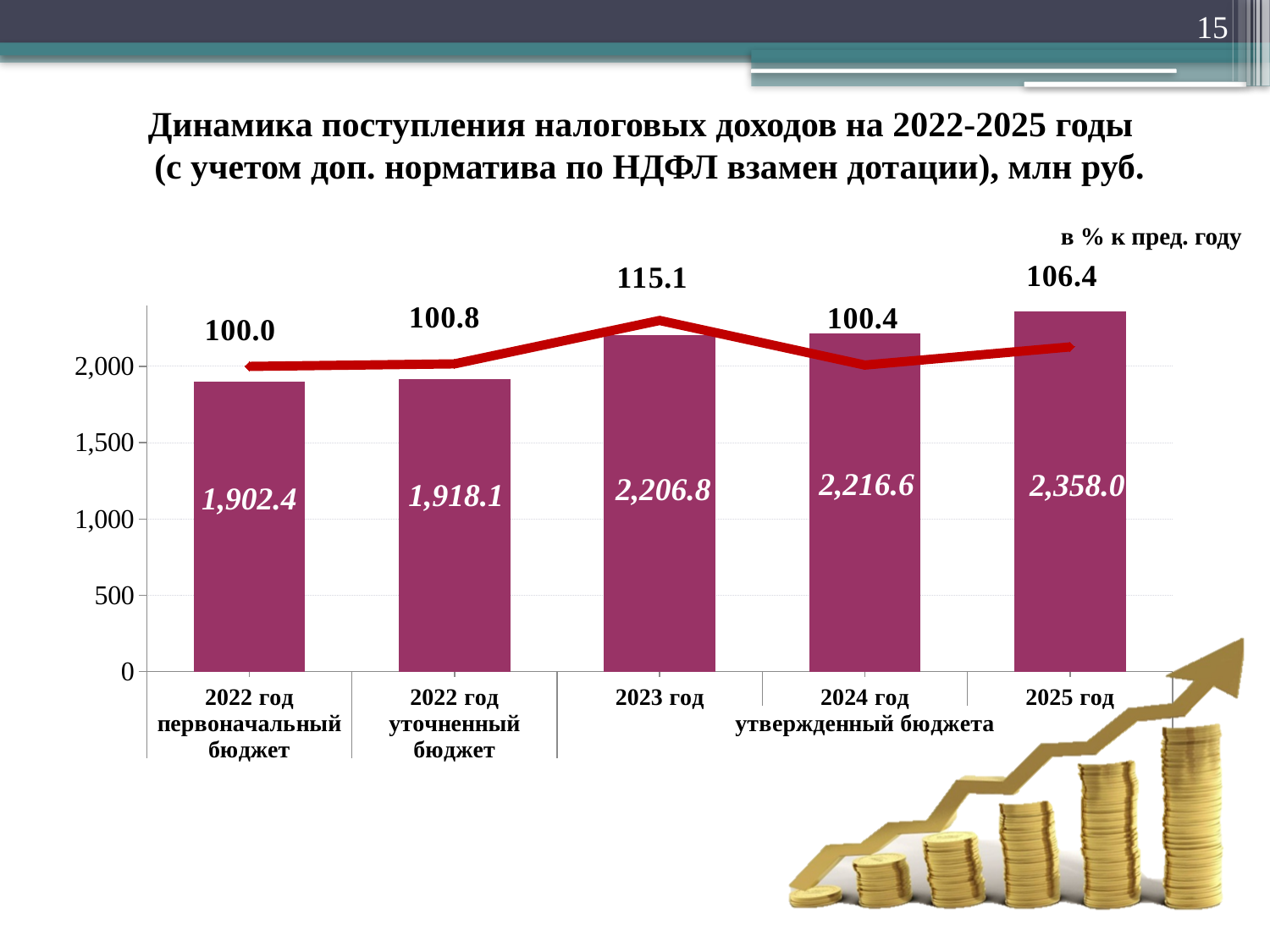
What is the value shown on the bar for 2022 год первоначальный бюджет? 1,902.4 How many bars are plotted in the chart? 5 Which category has the highest bar value? 2025 год Which is larger: the bar value for 2023 год or for 2024 год? 2024 год What is the difference between the bar values for 2022 год уточненный бюджет and 2022 год первоначальный бюджет? 15.7 Do the bar values rise or fall from left to right across the categories? rise Which category has the lowest bar value? 2022 год первоначальный бюджет What is the tax revenue value (млн руб.) shown for 2023 год? 2,206.8 What is the difference between the bar values for 2025 год and 2024 год? 141.4 Which year has the highest value on the red line (в % к пред. году)? 2023 год What percentage to the previous year (в % к пред. году) is shown for 2025 год? 106.4 What percentage to the previous year is shown for 2024 год? 100.4